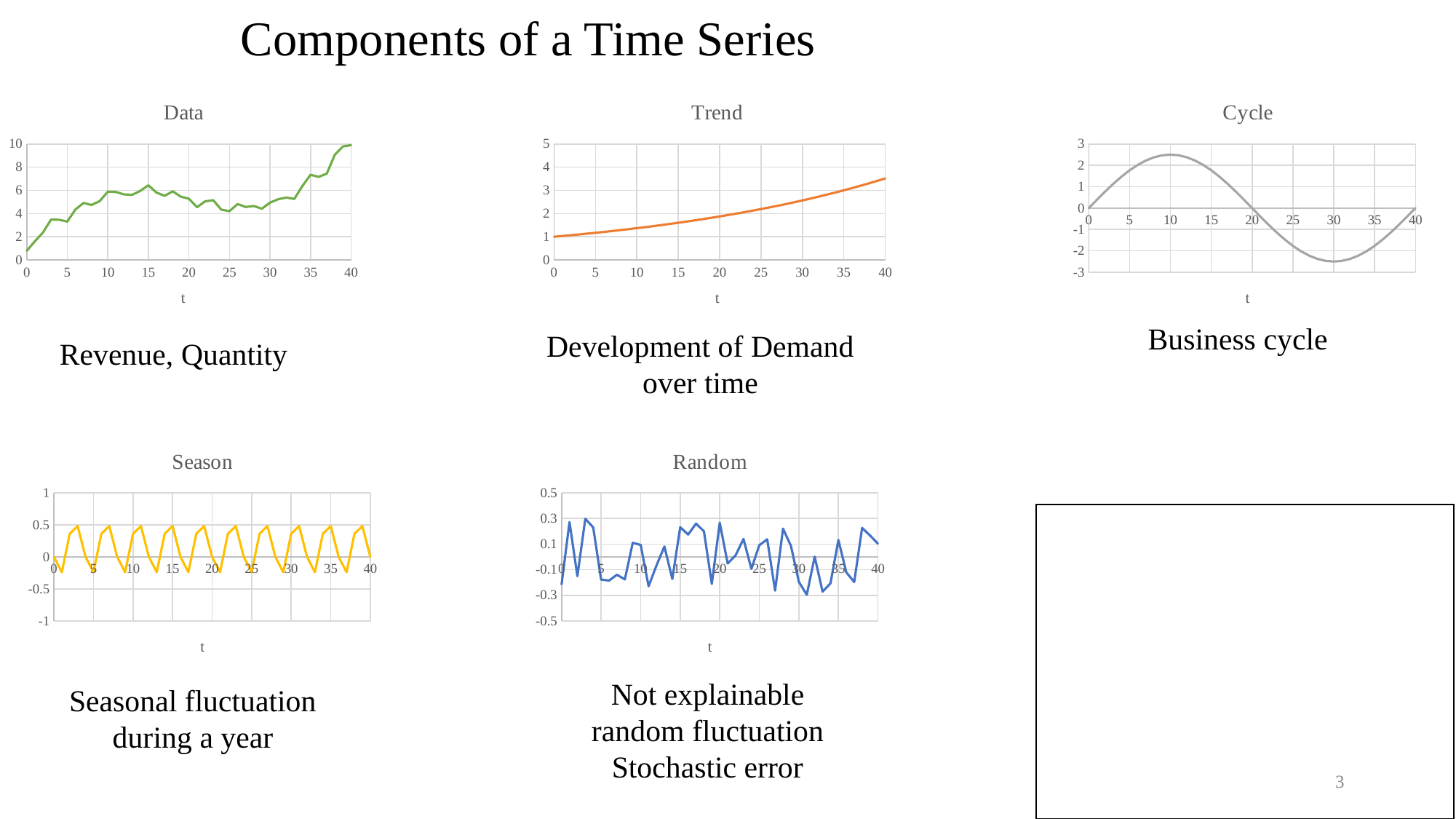
What kind of chart is the 'Data' chart? line chart In the 'Cycle' chart, is the value at t = 30 greater or less than -2? less In the 'Season' chart, is the highest value reached greater or less than 1? less In the 'Cycle' chart, is the value at t = 10 greater or less than 2? greater What is the x-axis label on the 'Season' chart? t In the 'Trend' chart, do the values rise or fall as t increases? rise In the 'Data' chart, which is larger: the value at t = 0 or the value at t = 40? t = 40 What is the title of the chart at the top right of the slide? Cycle